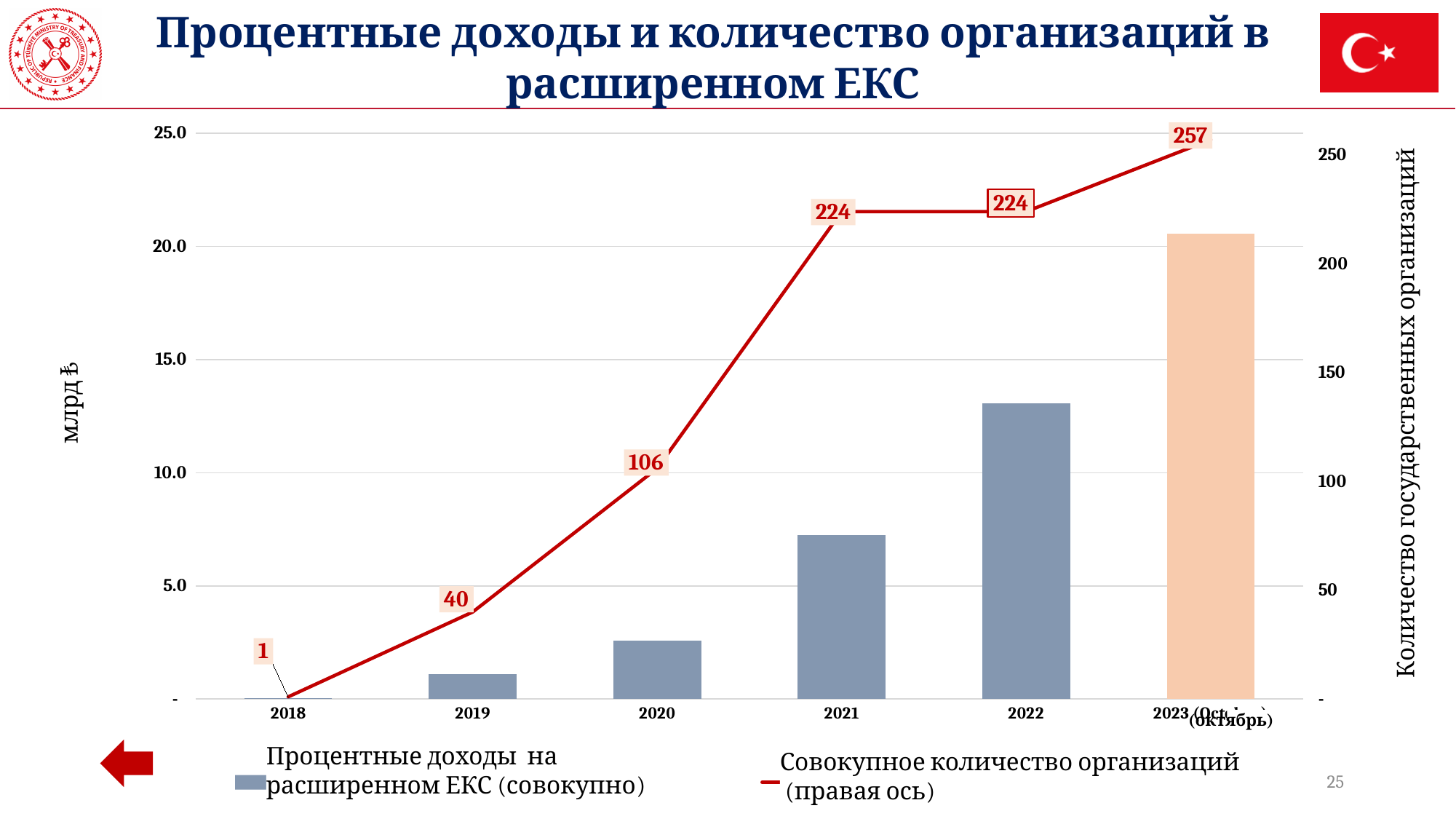
By how much did the cumulative number of organizations increase from 2022 to 2023 (октябрь)? 33 What is the difference in the cumulative number of organizations between 2021 and 2020? 118 What is the cumulative number of organizations shown for 2020? 106 In which year is the cumulative number of organizations the lowest? 2018 Is the interest income bar for 2022 greater or less than 10.0? greater In which year is the cumulative number of organizations the highest? 2023 (октябрь) Do the interest income bars rise or fall from 2018 to 2023 (октябрь)? rise What is the cumulative number of organizations shown for 2023 (октябрь)? 257 Which year has the taller bar for interest income, 2021 or 2022? 2022 How many years are shown on the x axis? 6 How many series does the legend list? 2 What is the cumulative number of organizations shown for 2019? 40